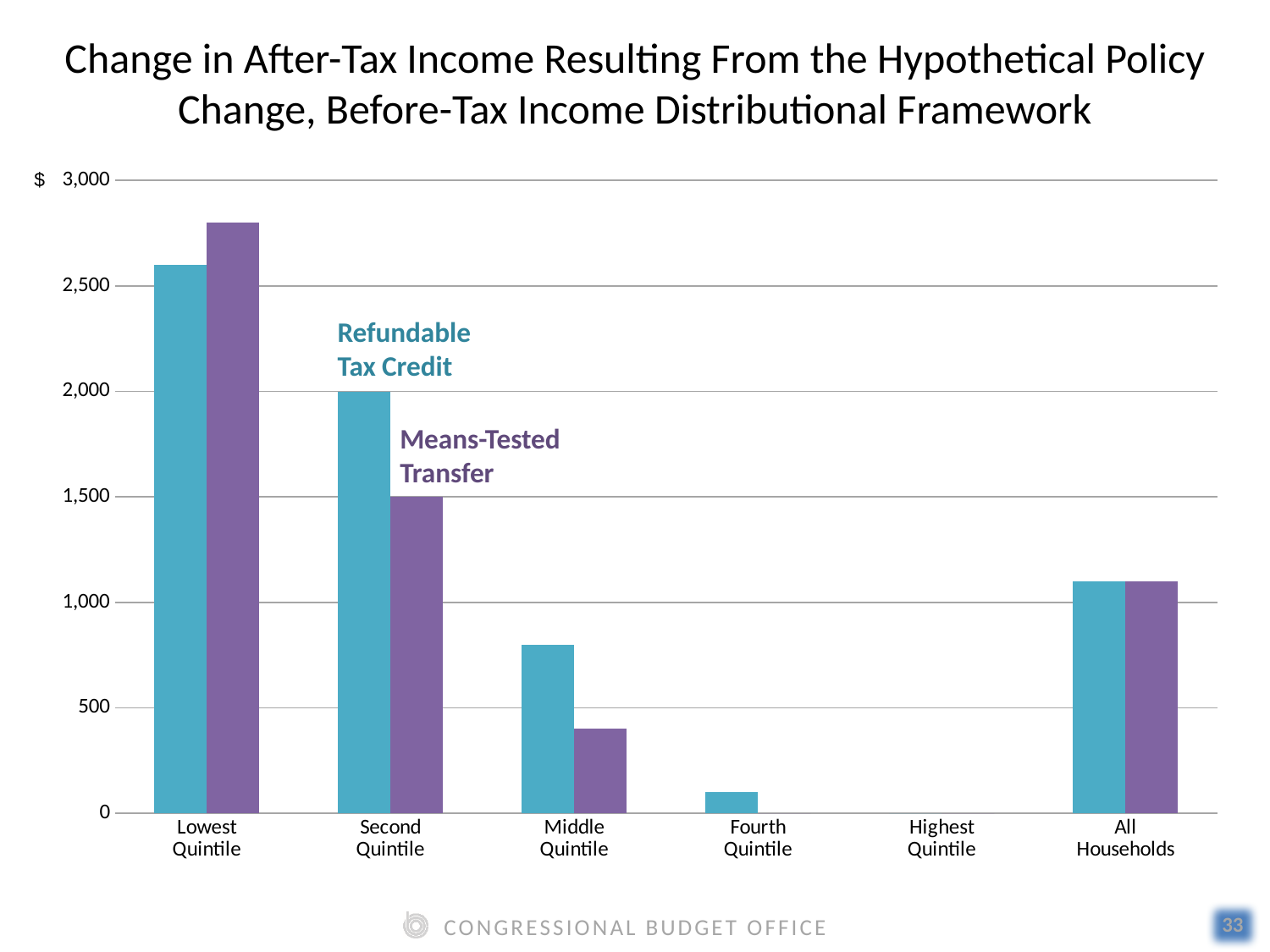
What is the Means-Tested Transfer value for the Second Quintile? 1,500 How many categories are shown on the x axis? 6 For which category is the Refundable Tax Credit value highest? Lowest Quintile What is the Refundable Tax Credit value for the Second Quintile? 2,000 Is the Means-Tested Transfer value for the Middle Quintile greater or less than 500? less For which quintile is the Means-Tested Transfer value lowest? Fourth Quintile and Highest Quintile (both 0) What is the difference between the Refundable Tax Credit and Means-Tested Transfer values for the Second Quintile? 500 Do the Refundable Tax Credit values rise or fall from the Lowest Quintile to the Highest Quintile? Fall Is the Refundable Tax Credit value for All Households greater or less than 1,000? greater For the Lowest Quintile, which is larger: the Refundable Tax Credit or the Means-Tested Transfer? Means-Tested Transfer How many series does the chart show? 2 What type of chart is shown on the slide? Bar chart